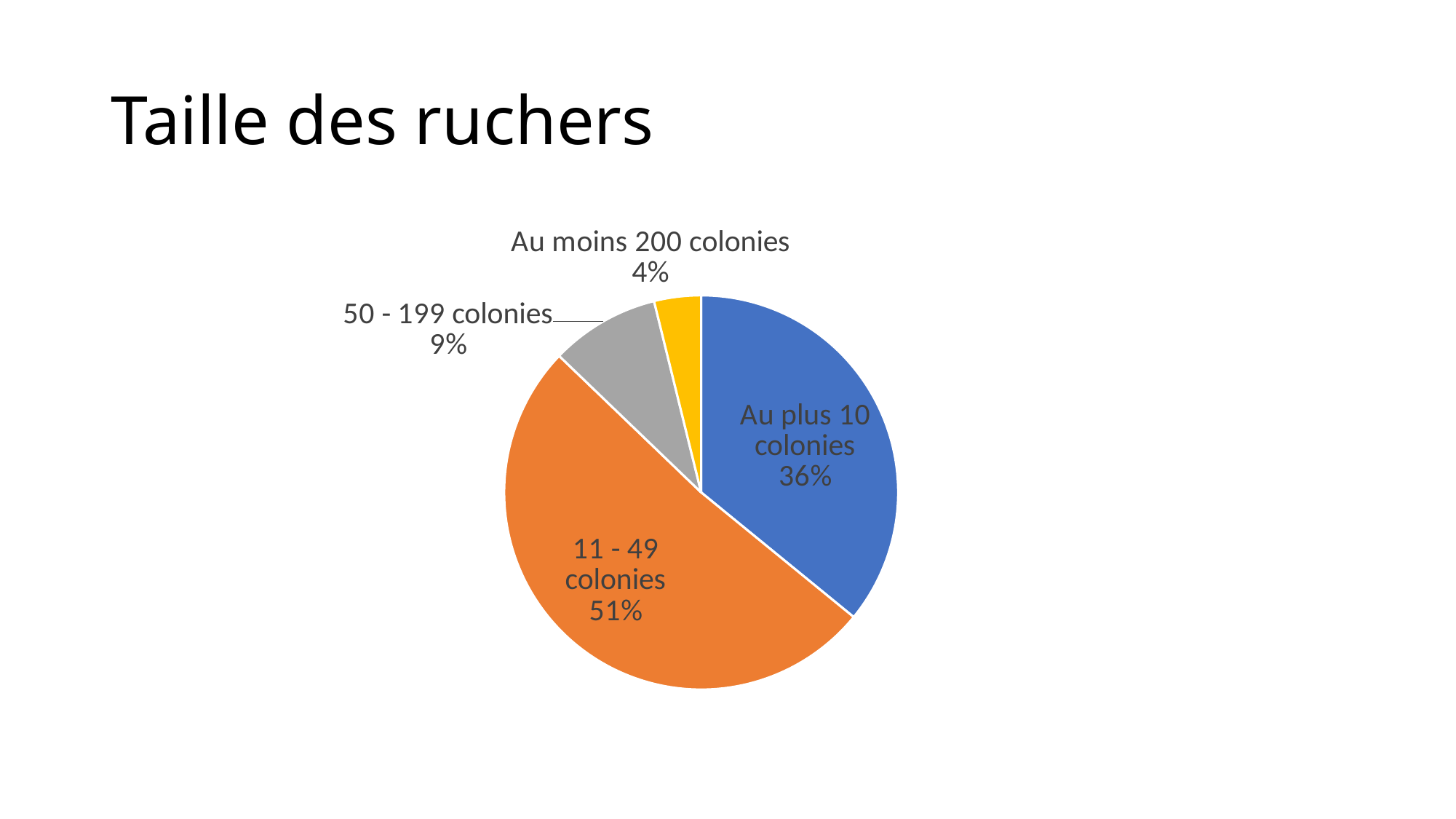
Which is larger, the share for "50 - 199 colonies" or the share for "Au moins 200 colonies"? 50 - 199 colonies What kind of chart is shown on the slide? pie chart What share of the pie does "50 - 199 colonies" represent? 9% Which category has the largest slice of the pie? 11 - 49 colonies What is the title of the slide containing the pie chart? Taille des ruchers Which category has the smallest slice of the pie? Au moins 200 colonies How many categories are shown in the pie chart? 4 What share of the pie does "11 - 49 colonies" represent? 51% What colour is the slice for "Au plus 10 colonies"? blue What share of the pie does "Au plus 10 colonies" represent? 36% What is the difference in percentage points between "11 - 49 colonies" and "Au plus 10 colonies"? 15